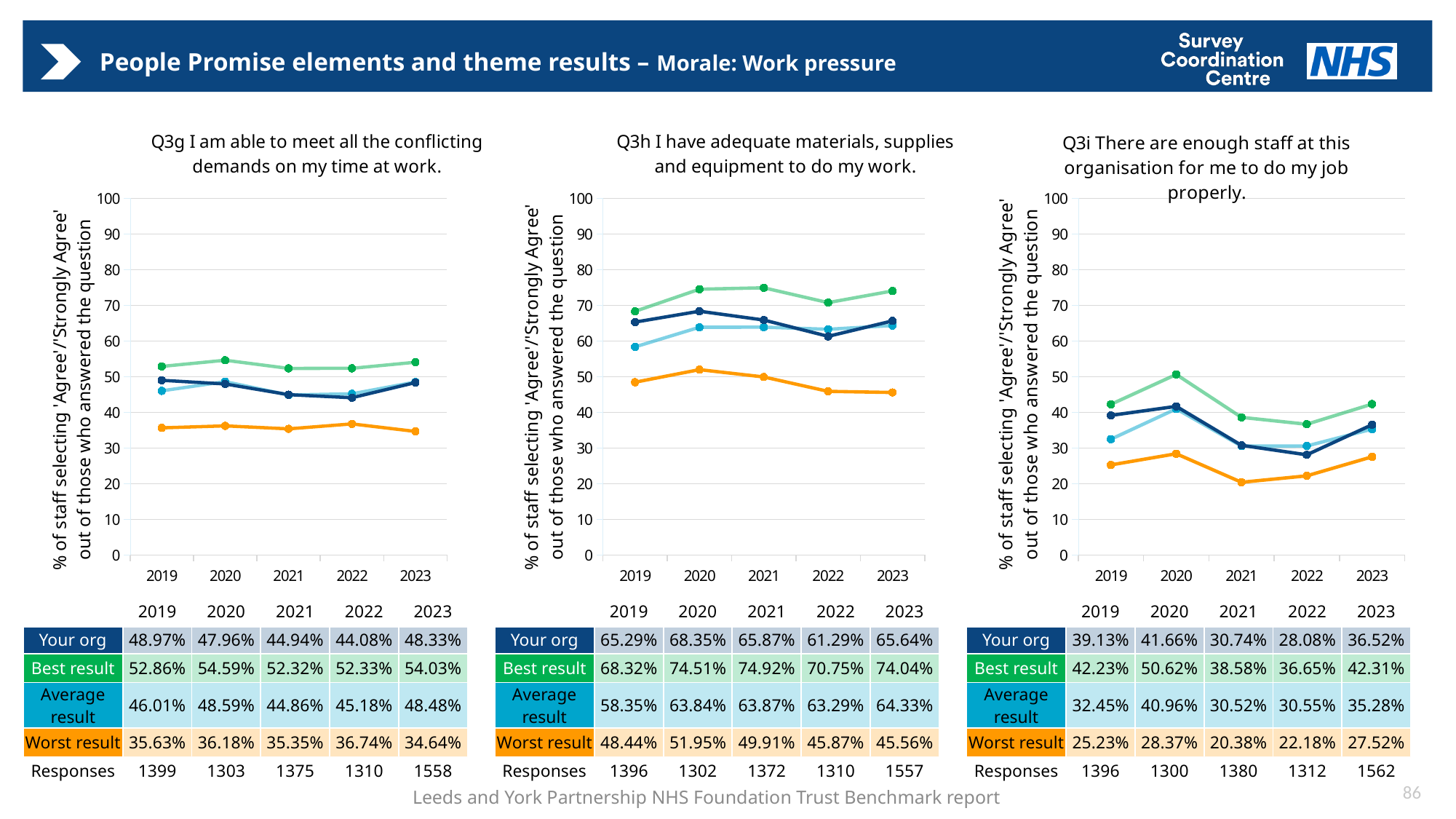
In the Q3h chart, how much did the 'Your org' value fall from 2020 to 2022? 7.06% In the Q3h chart, is the 'Your org' value for 2020 greater or less than 60? greater In the Q3h chart, in which year is the 'Your org' value lowest? 2022 In the Q3i chart, in which year is the 'Your org' value highest? 2020 How many years are shown on the x axis of the Q3g chart? 5 How many result series (lines) are plotted in the Q3i chart? 4 In the Q3h chart (I have adequate materials, supplies and equipment to do my work), what is the 'Best result' value for 2021? 74.92% In the Q3g chart, what is the difference between the 'Best result' and 'Your org' values for 2023? 5.70% In the Q3i chart (There are enough staff at this organisation for me to do my job properly), what is the 'Worst result' value for 2021? 20.38% In the Q3i chart, which is larger for 2022: 'Your org' or 'Average result'? Average result In the Q3g chart (I am able to meet all the conflicting demands on my time at work), what is the 'Your org' value for 2023? 48.33% What type of chart is used for Q3h? Line chart